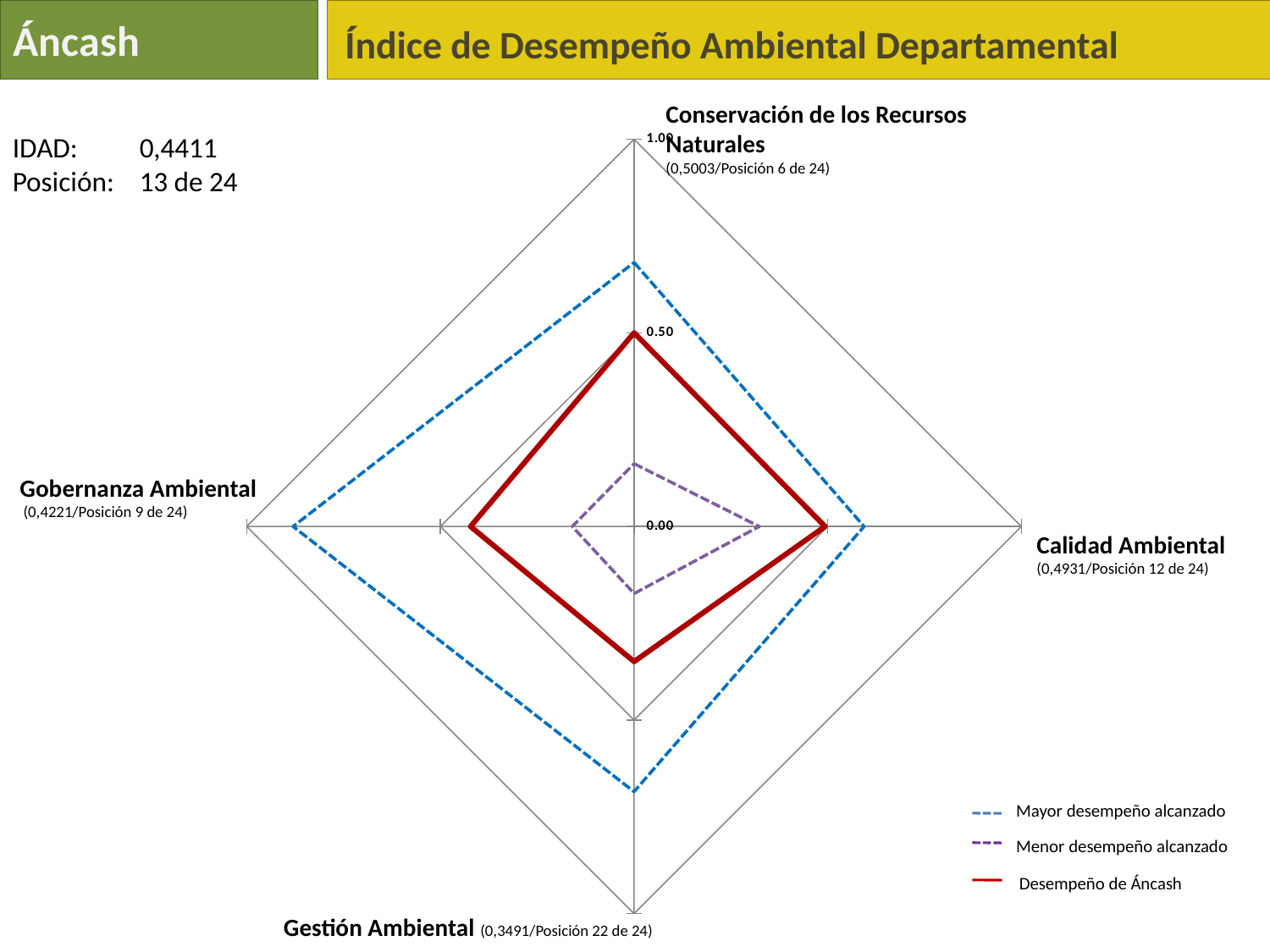
What is Áncash's value for Gestión Ambiental? 0,3491 In which category does Áncash have its highest value? Conservación de los Recursos Naturales What is Áncash's value for Conservación de los Recursos Naturales? 0,5003 Is the 'Menor desempeño alcanzado' value for Conservación de los Recursos Naturales greater or less than 0.50? less How many series does the legend list? 3 What is the difference between Áncash's values for Conservación de los Recursos Naturales and Gestión Ambiental? 0,1512 What is Áncash's value for Calidad Ambiental? 0,4931 In which category does Áncash have its lowest value? Gestión Ambiental What kind of chart is shown on the slide? Radar chart Which is larger for Áncash: Gobernanza Ambiental or Gestión Ambiental? Gobernanza Ambiental Is the 'Mayor desempeño alcanzado' value for Gestión Ambiental greater or less than 0.50? greater How many categories (axes) does the radar chart have? 4